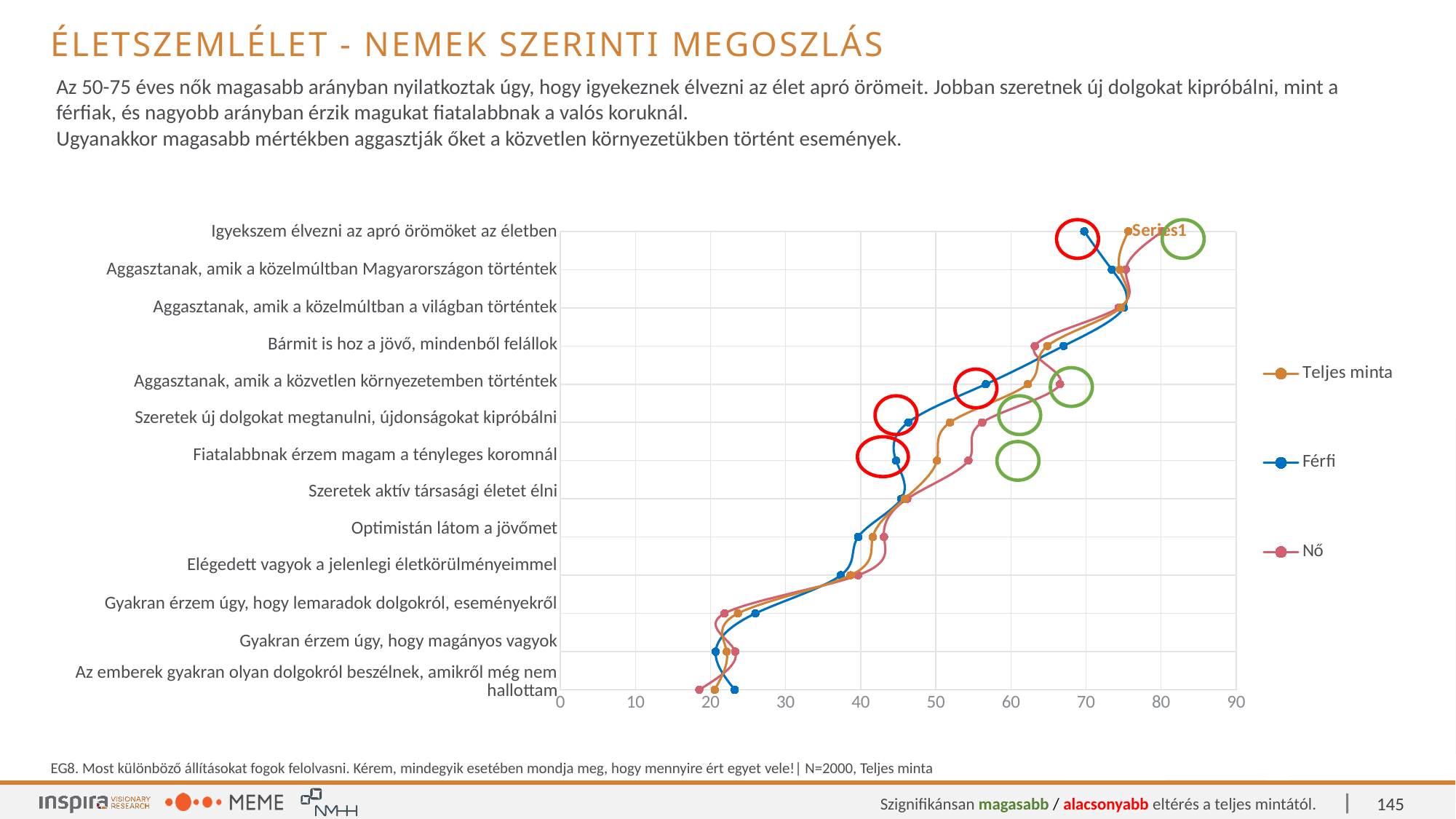
Which series are listed in the chart legend? Teljes minta, Férfi, Nő Is the Nő value for 'Aggasztanak, amik a közvetlen környezetemben történtek' greater or less than 60? greater For 'Aggasztanak, amik a közvetlen környezetemben történtek', which series has the larger value, Férfi or Nő? Nő Is the Teljes minta value for 'Optimistán látom a jövőmet' greater or less than 50? less How many statement categories are plotted on the chart? 13 For 'Szeretek új dolgokat megtanulni, újdonságokat kipróbálni', which series has the larger value, Férfi or Nő? Nő What kind of chart is shown on the slide? line chart Which category has the lowest value for the Nő series? Az emberek gyakran olyan dolgokról beszélnek, amikről még nem hallottam Which category has the highest value for the Férfi series? Aggasztanak, amik a közelmúltban a világban történtek How many series does the chart legend list? 3 Is the Férfi value for 'Fiatalabbnak érzem magam a tényleges koromnál' greater or less than 50? less